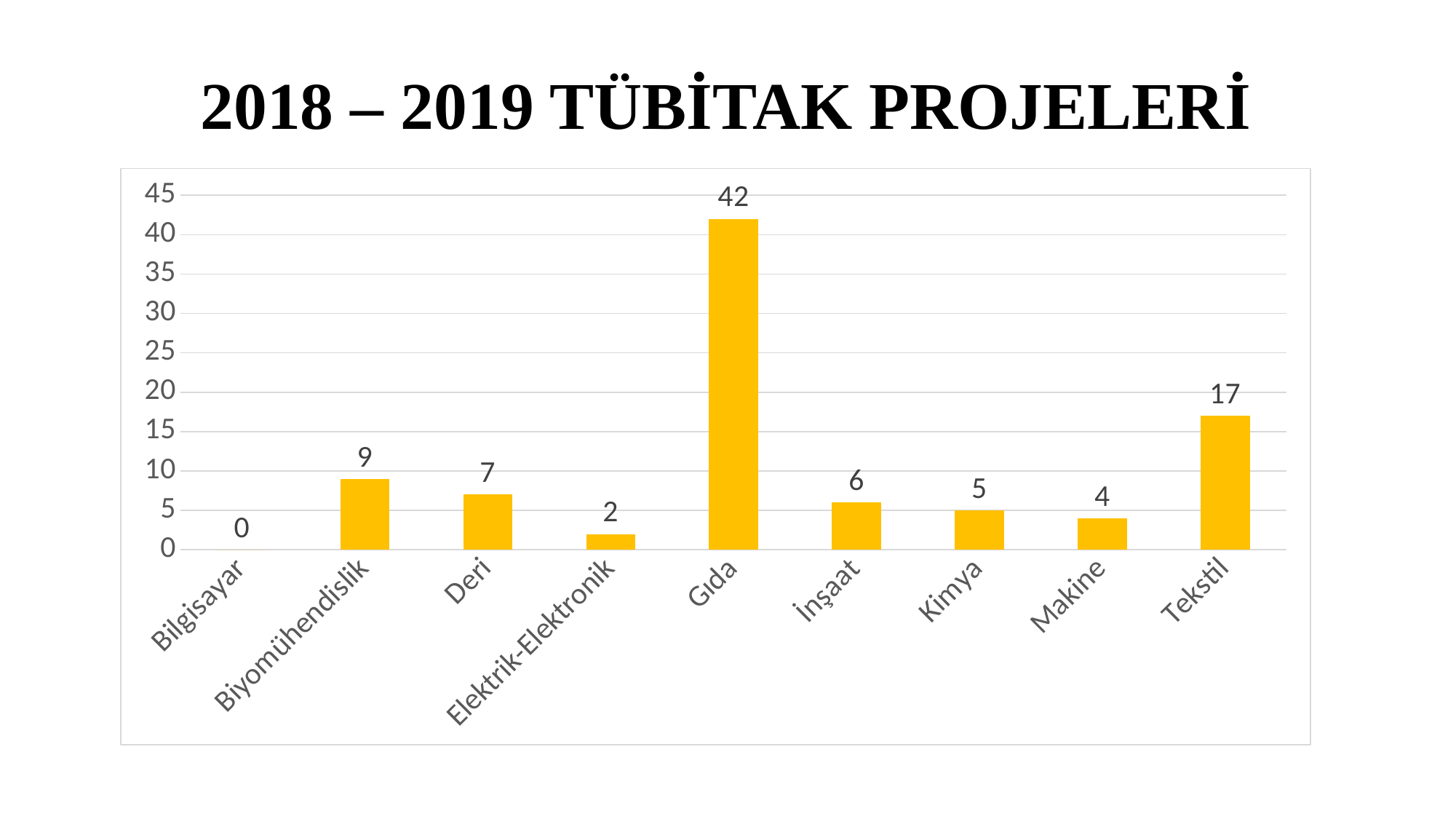
Is the value for Tekstil greater or less than 15? greater What is the value for Gıda? 42 Which is larger, the value for İnşaat or the value for Kimya? İnşaat Which category has the highest value? Gıda What kind of chart is shown on the slide? Bar chart Which category has the lowest value? Bilgisayar What is the value for Bilgisayar? 0 How many categories are shown on the x axis? 9 What is the difference between the values for Gıda and Tekstil? 25 What is the value for Biyomühendislik? 9 What is the difference between the values for Deri and Elektrik-Elektronik? 5 What is the value for Tekstil? 17